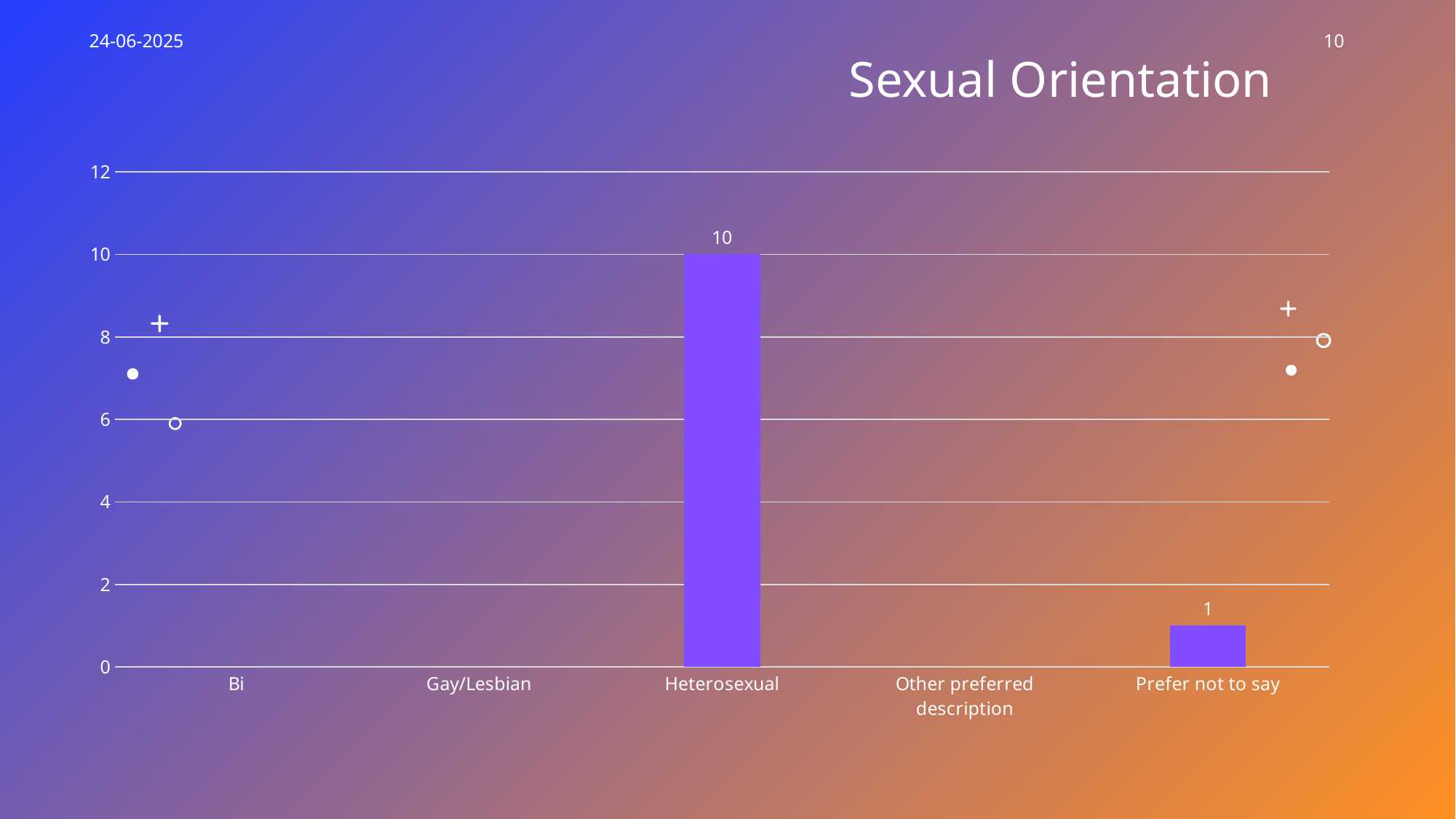
What kind of chart is shown on the slide? bar chart Which category has the highest value? Heterosexual What is the value for Prefer not to say? 1 How many categories are shown on the x axis? 5 What is the highest value shown on the y axis? 12 What is the difference between the values for Heterosexual and Prefer not to say? 9 What is the value for Heterosexual? 10 Is the value for Prefer not to say greater or less than 2? less Is the value for Heterosexual greater or less than 8? greater What is the title of the chart? Sexual Orientation Which is larger, the value for Heterosexual or the value for Prefer not to say? Heterosexual